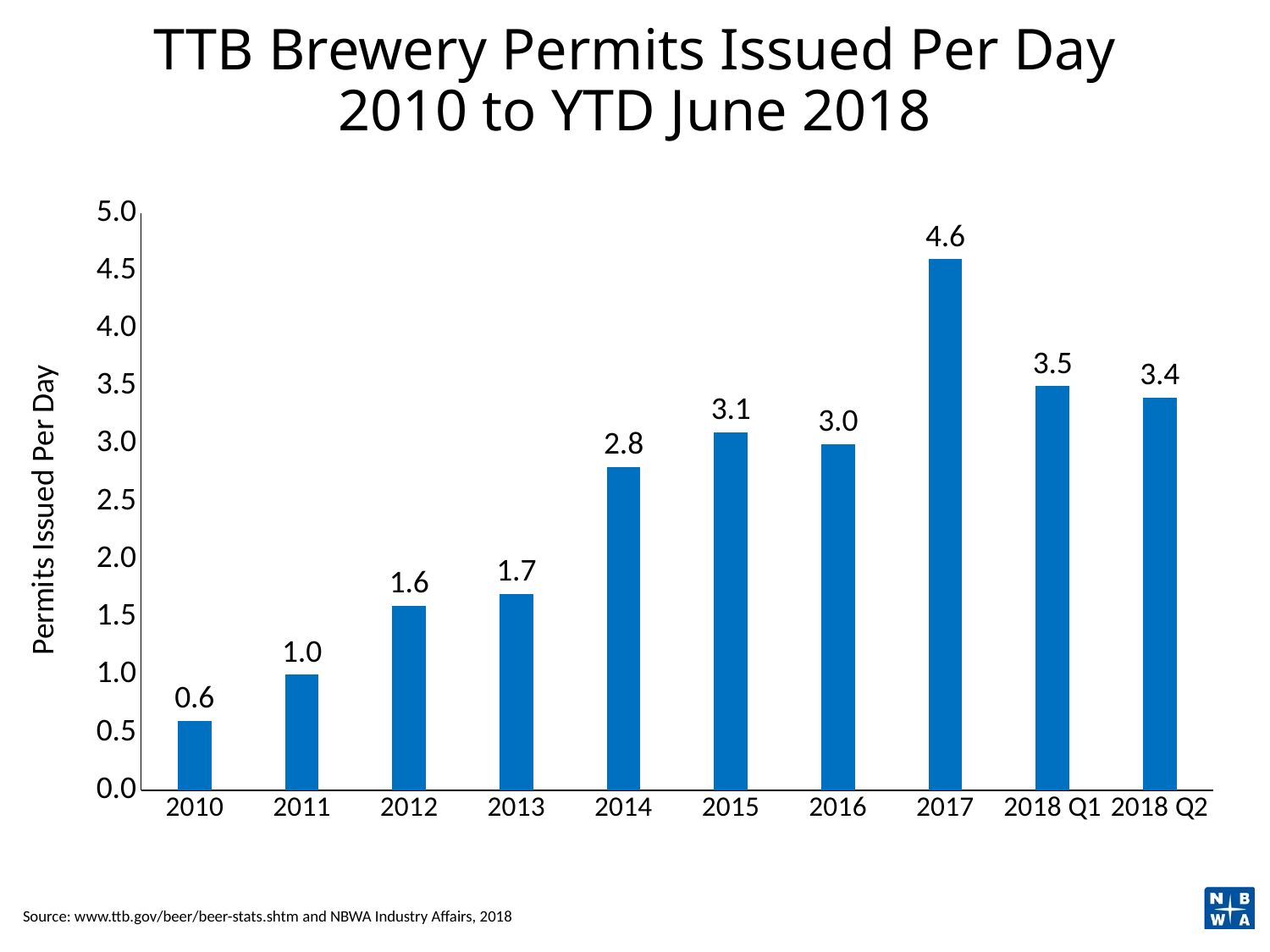
Which is larger, the value for 2014 or the value for 2013? 2014 What is the value for 2017? 4.6 What is the value for 2010? 0.6 Is the value for 2015 greater or less than 2.0? greater What kind of chart is this? bar chart Which category has the highest value? 2017 Do the values generally rise or fall from 2010 to 2017? rise What is the value for 2018 Q2? 3.4 How many categories are shown on the x axis? 10 What is the title of the chart? TTB Brewery Permits Issued Per Day 2010 to YTD June 2018 Which category has the lowest value? 2010 What is the difference between the values for 2017 and 2016? 1.6